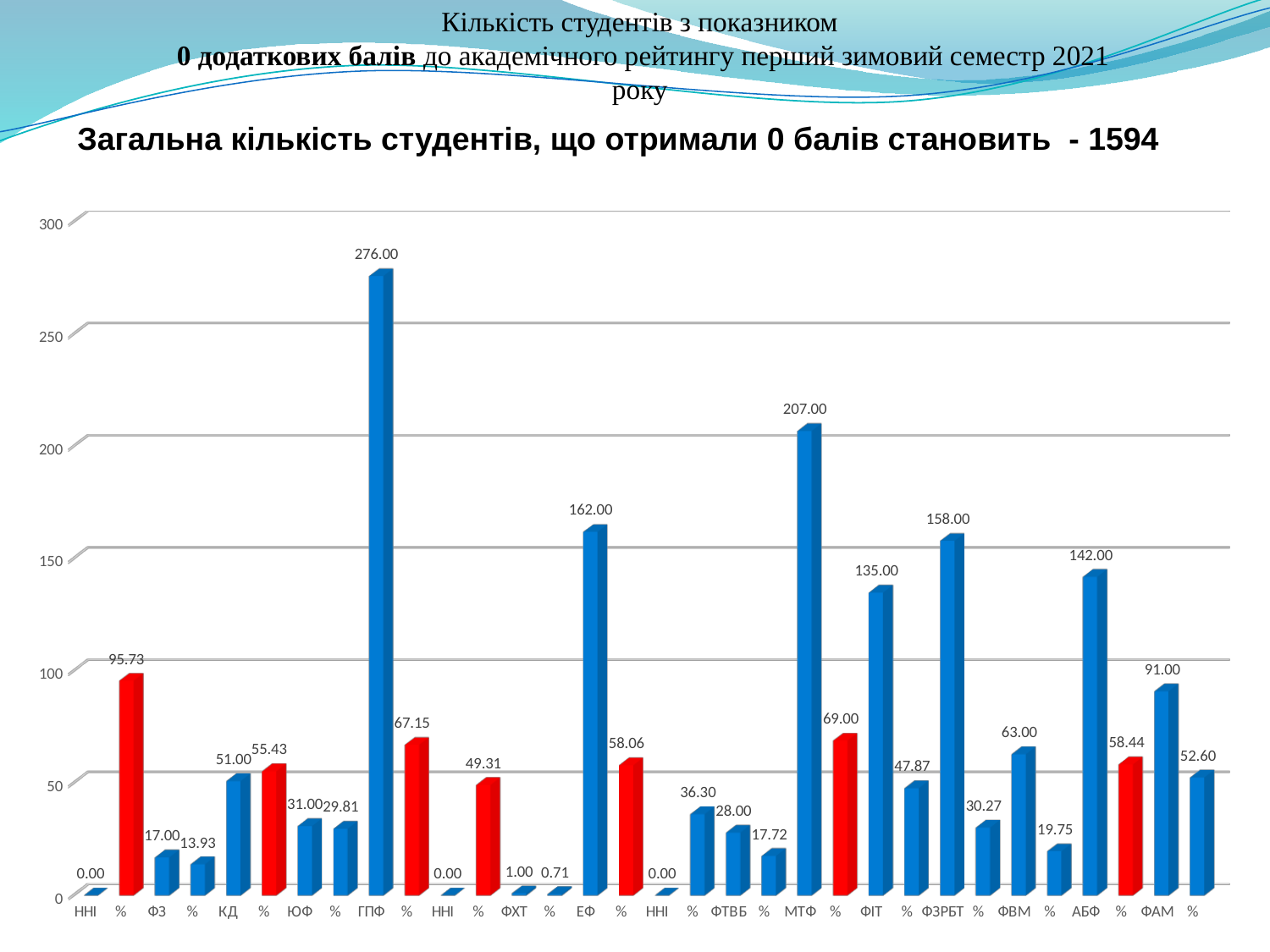
Which faculty has the highest value on the chart? ГПФ Which is larger, the value for ФІТ or the value for АБФ? АБФ Is the value for ФАМ greater or less than 100? less What is the value for ЕФ? 162.00 What is the value for ГПФ? 276.00 What is the value for ФЗРБТ? 158.00 What is the value for ФХТ? 1.00 What is the value for ФВМ? 63.00 What kind of chart is shown on the slide? bar chart According to the heading above the chart, what is the total number of students who received 0 points? 1594 What is the difference between the values for ГПФ and МТФ? 69.00 What is the value for МТФ? 207.00